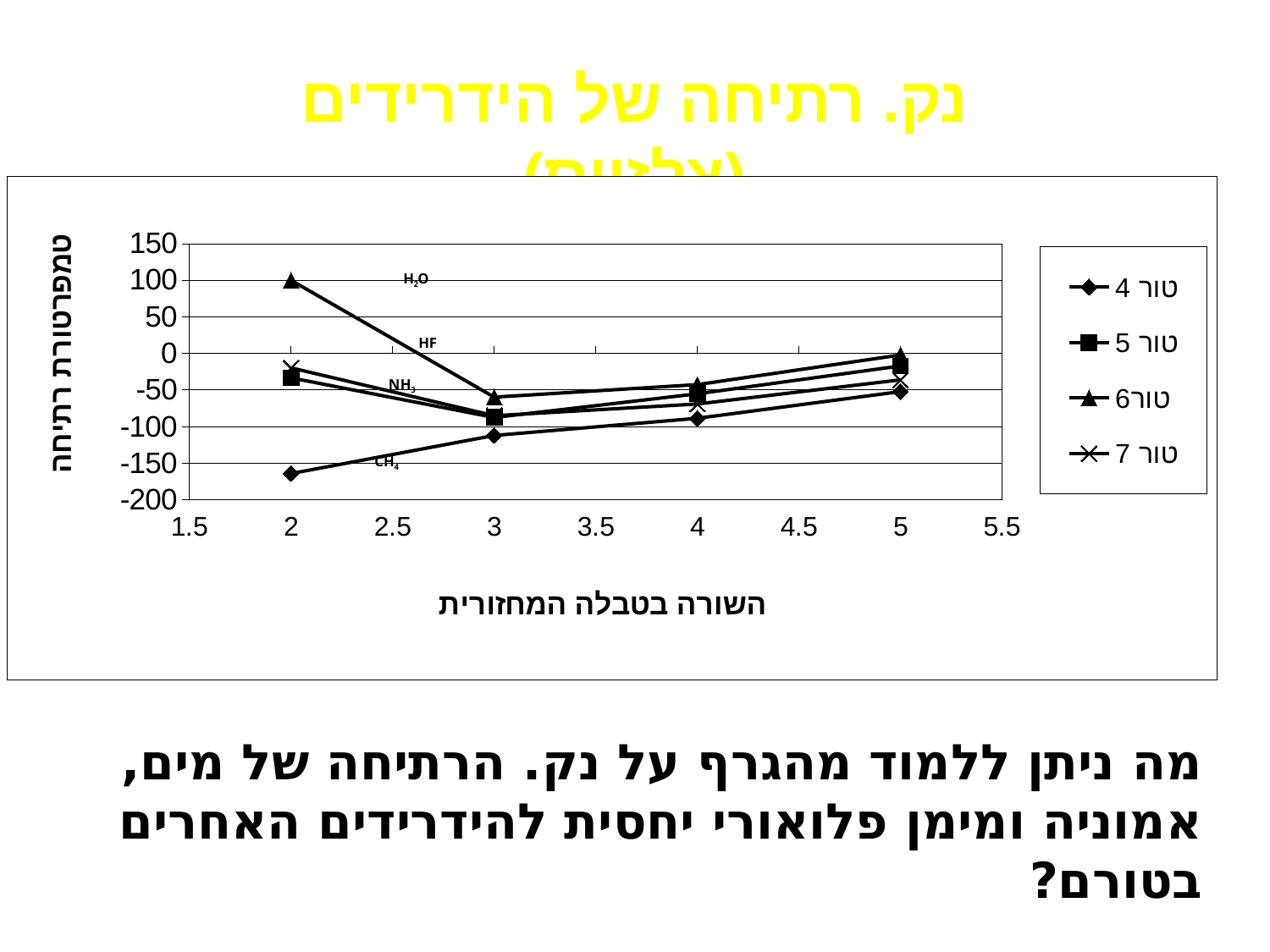
Do the values of the טור 4 series rise or fall as x increases from 2 to 5? rise Which series has the lowest value at x = 2? טור 4 What is the value of the טור6 series at x = 2? 100 What is the title of the y-axis? טמפרטורת רתיחה How many series does the legend list? 4 At x = 5, which series has the larger value, טור6 or טור 4? טור6 Is the value for טור6 at x = 3 greater or less than -100? greater At how many x-axis positions are data points plotted for each series? 4 Which series has the highest value at x = 2? טור6 Is the value for טור 4 at x = 2 greater or less than -150? less Is the value for טור 7 at x = 2 greater or less than -50? greater What kind of chart is shown on the slide? line chart